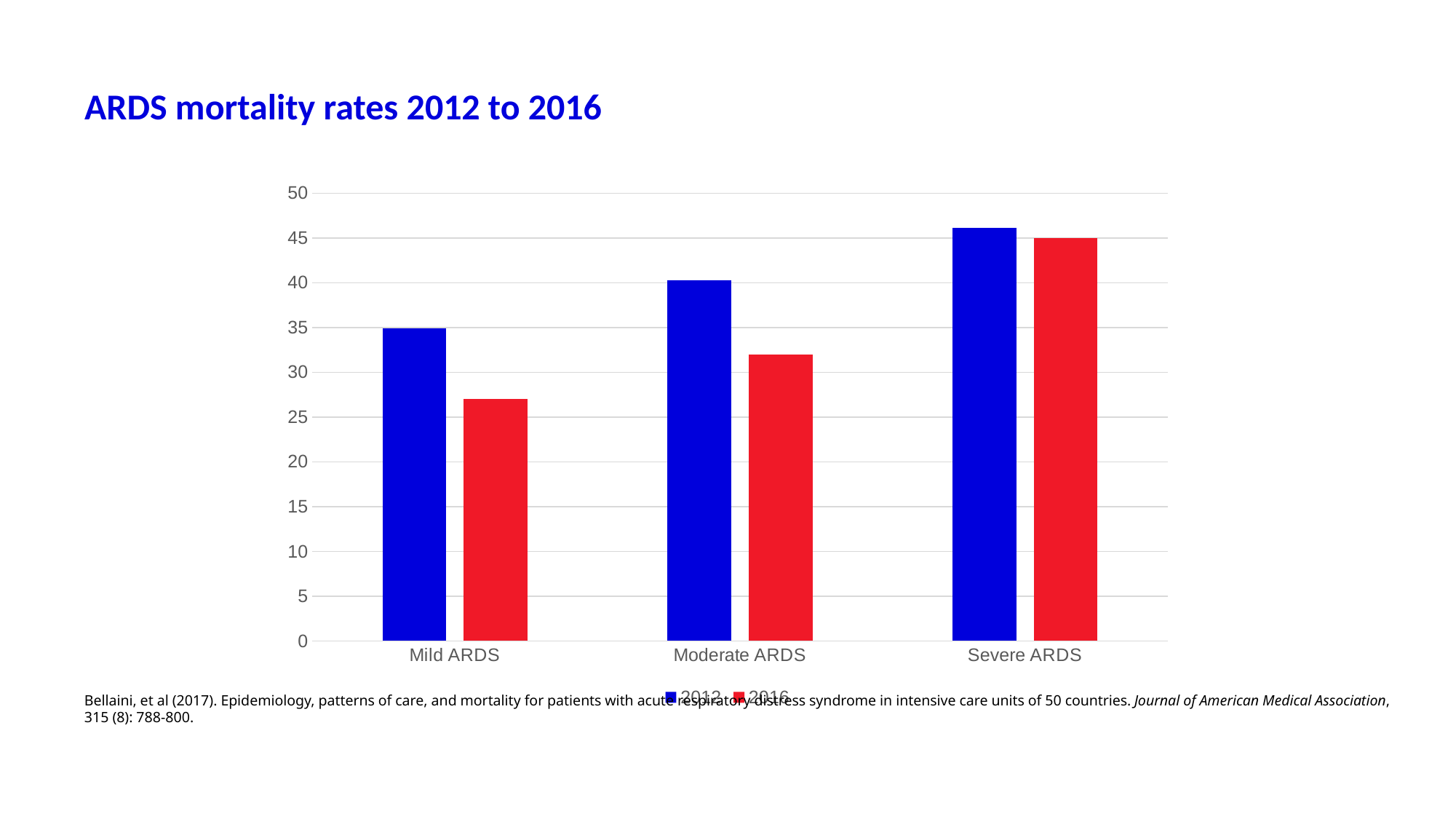
Is the 2016 value for Mild ARDS greater or less than 30? less For Moderate ARDS, which is larger, the 2012 value or the 2016 value? 2012 Is the 2012 value for Severe ARDS greater or less than 45? greater Which category has the lowest 2016 value? Mild ARDS Is the 2012 value for Mild ARDS greater or less than 30? greater What is the title of the chart? ARDS mortality rates 2012 to 2016 How many categories are shown on the x axis? 3 What kind of chart is shown on the slide? Bar chart How many series does the legend list? 2 Which category has the highest 2012 value? Severe ARDS Do the 2016 values rise or fall from Mild ARDS to Severe ARDS? rise